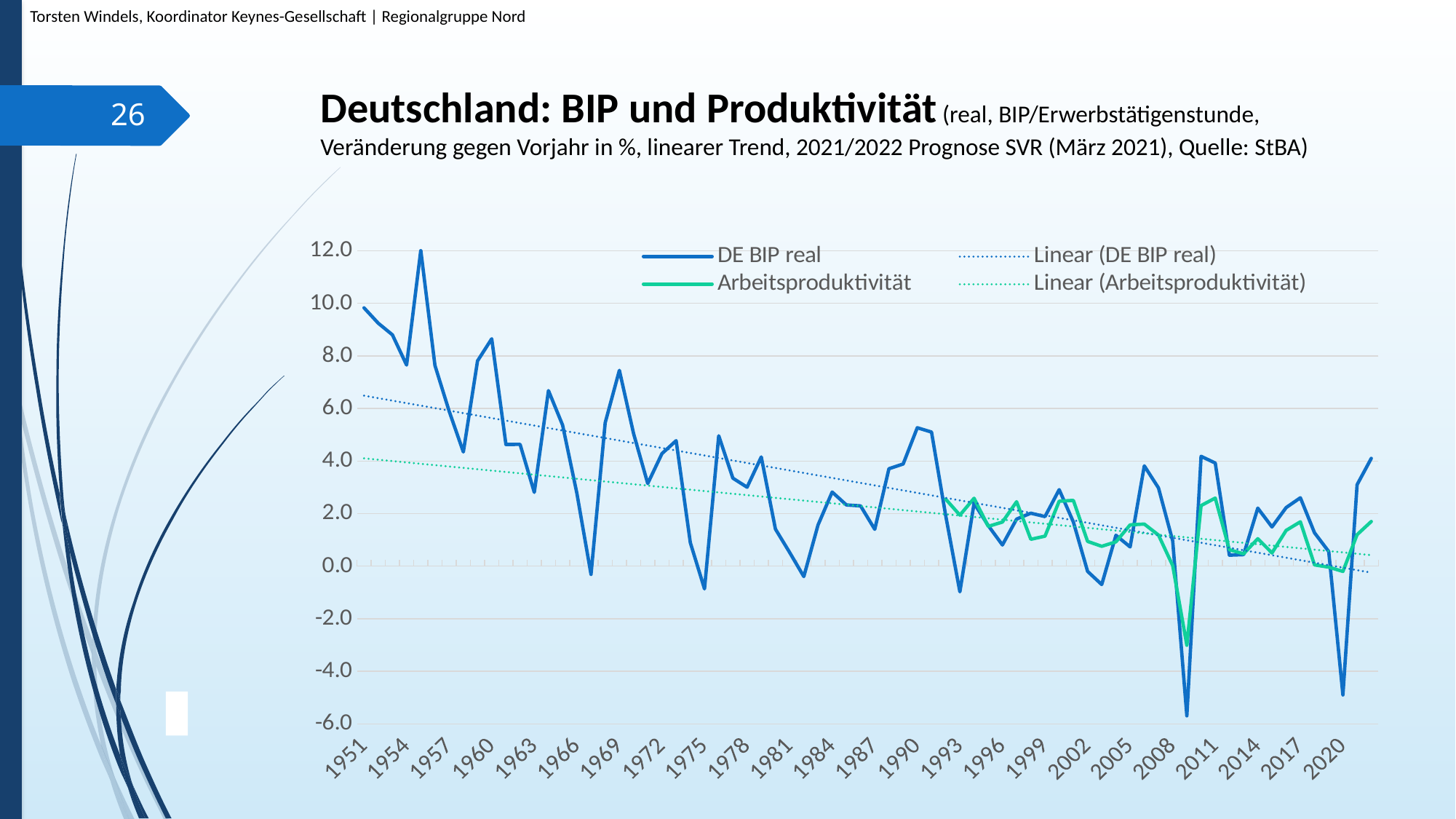
In which year does the DE BIP real line reach its lowest value? 2009 What is the highest value shown on the y axis? 12.0 Is the value of DE BIP real in 1951 greater or less than 8.0? greater In 2020, which series has the lower value, DE BIP real or Arbeitsproduktivität? DE BIP real Is the value of DE BIP real in 2009 greater or less than -4.0? less Does the dotted linear trend line for DE BIP real rise or fall from 1951 to 2020? fall How many year labels are shown on the x axis? 24 Is the peak value of DE BIP real around 1955 greater or less than 10.0? greater How many entries does the chart legend list? 4 Which series is drawn in green in the chart? Arbeitsproduktivität What kind of chart is shown on the slide? line chart